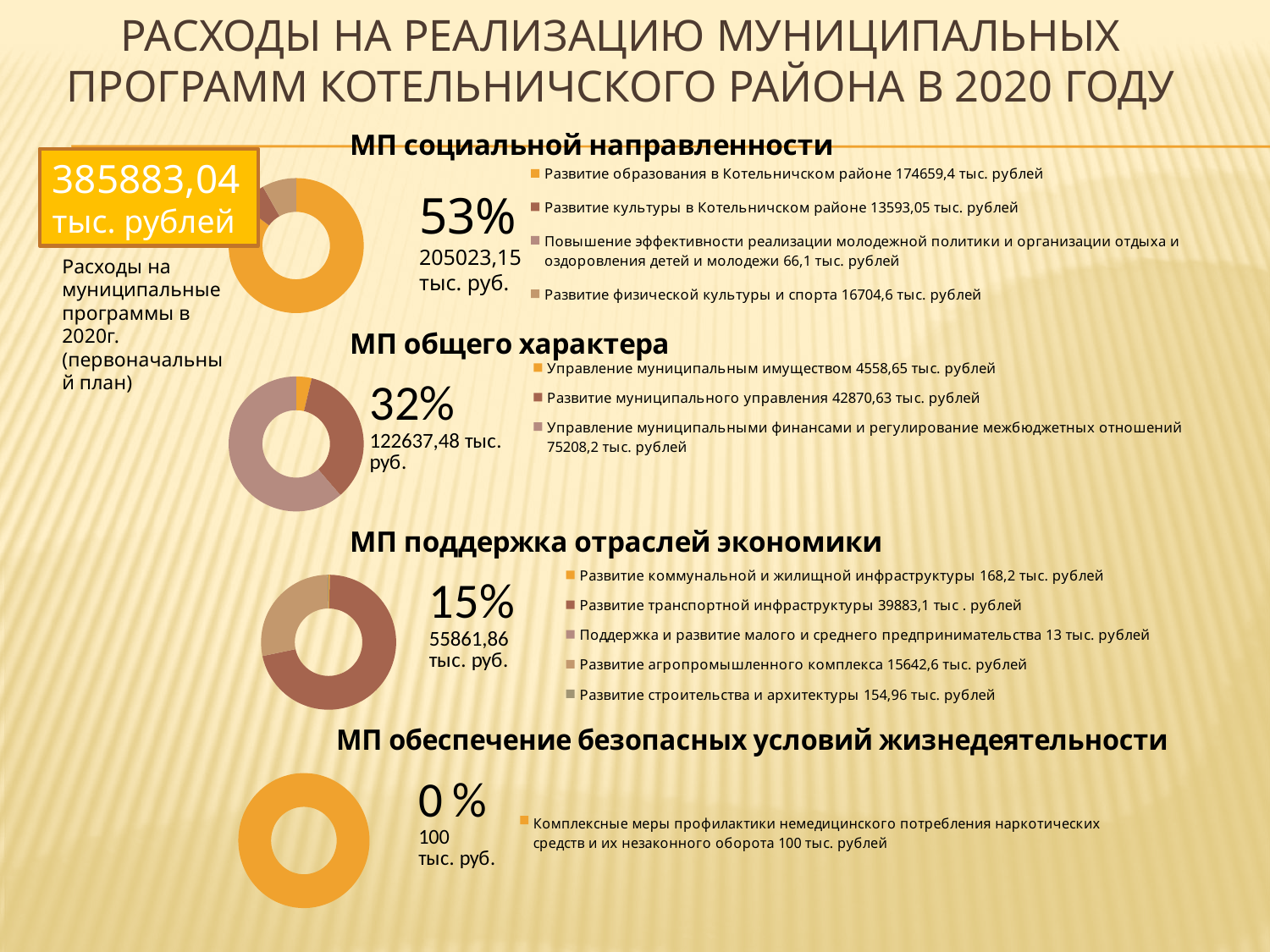
In the «МП социальной направленности» chart, how many categories does the legend list? 4 In the «МП общего характера» chart, what is the value for «Развитие муниципального управления»? 42870,63 тыс. рублей What percentage share is printed next to the «МП общего характера» chart? 32% What kind of chart is used for «МП социальной направленности»? Doughnut (pie) chart In the «МП поддержка отраслей экономики» chart, which is larger: «Развитие транспортной инфраструктуры» or «Развитие агропромышленного комплекса»? Развитие транспортной инфраструктуры In the «МП социальной направленности» chart, which category has the lowest value? Повышение эффективности реализации молодежной политики и организации отдыха и оздоровления детей и молодежи In the «МП общего характера» chart, which category has the highest value? Управление муниципальными финансами и регулирование межбюджетных отношений In the «МП обеспечение безопасных условий жизнедеятельности» chart, what is the value for «Комплексные меры профилактики немедицинского потребления наркотических средств и их незаконного оборота»? 100 тыс. рублей In the «МП поддержка отраслей экономики» chart, how many categories does the legend list? 5 In the «МП социальной направленности» chart, what is the value for «Развитие образования в Котельничском районе»? 174659,4 тыс. рублей In the «МП поддержка отраслей экономики» chart, what is the difference between «Развитие коммунальной и жилищной инфраструктуры» (168,2) and «Развитие строительства и архитектуры» (154,96)? 13,24 тыс. рублей What total is printed next to the «МП социальной направленности» chart? 205023,15 тыс. руб.